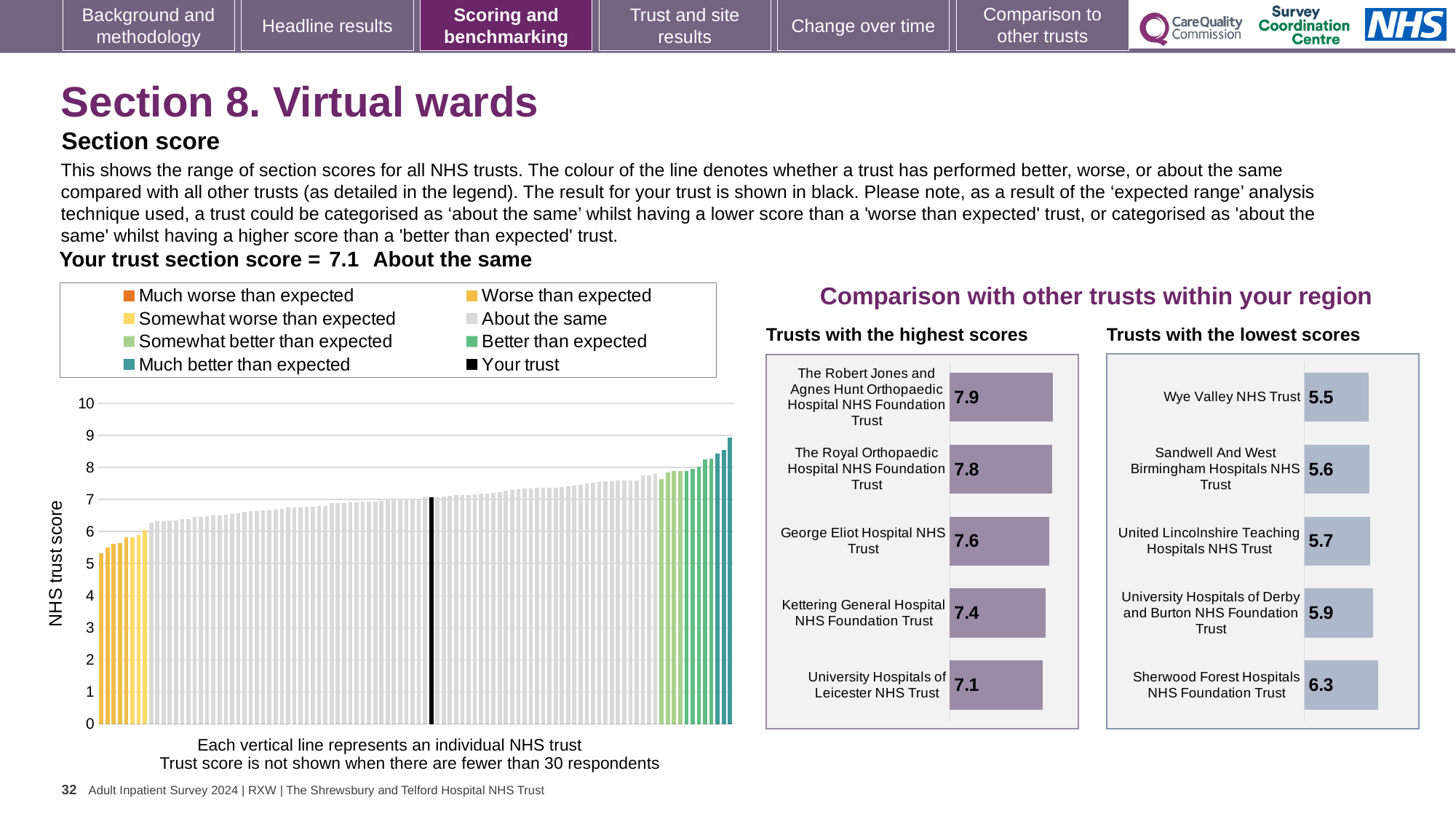
On the NHS trust score chart on the left, do the bars rise or fall from left to right? Rise On the 'Trusts with the lowest scores' chart, what is the score for Wye Valley NHS Trust? 5.5 On the 'Trusts with the highest scores' chart, what is the score for The Robert Jones and Agnes Hunt Orthopaedic Hospital NHS Foundation Trust? 7.9 On the 'Trusts with the highest scores' chart, what is the difference between the scores of The Robert Jones and Agnes Hunt Orthopaedic Hospital NHS Foundation Trust and University Hospitals of Leicester NHS Trust? 0.8 On the NHS trust score chart on the left, is the value of the tallest bar greater or less than 8? greater What kind of chart is the NHS trust score chart on the left of the slide? Bar chart On the 'Trusts with the lowest scores' chart, which has the larger score: Sandwell And West Birmingham Hospitals NHS Trust or University Hospitals of Derby and Burton NHS Foundation Trust? University Hospitals of Derby and Burton NHS Foundation Trust On the 'Trusts with the highest scores' chart, what is the score for Kettering General Hospital NHS Foundation Trust? 7.4 On the 'Trusts with the lowest scores' chart, how many trusts are listed? 5 On the NHS trust score chart on the left, how many entries does the legend list? 8 On the 'Trusts with the lowest scores' chart, which trust has the highest score? Sherwood Forest Hospitals NHS Foundation Trust On the 'Trusts with the highest scores' chart, which trust has the lowest score? University Hospitals of Leicester NHS Trust